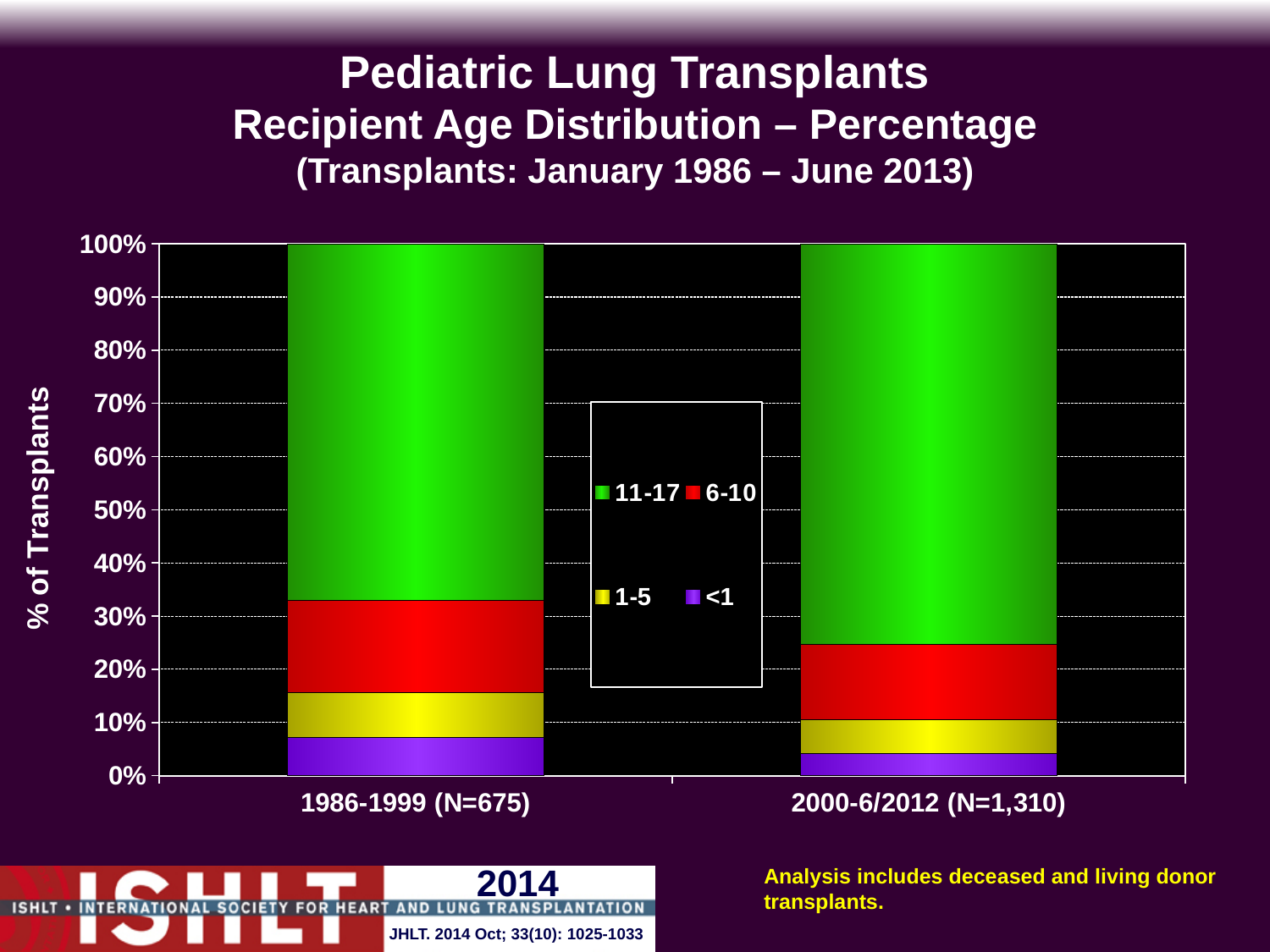
Is the share of 11-17 year old recipients larger in 1986-1999 or in 2000-6/2012? 2000-6/2012 Which age group makes up the largest share of transplants in the 1986-1999 (N=675) bar? 11-17 Which age group makes up the smallest share of transplants in the 2000-6/2012 (N=1,310) bar? <1 Is the share of <1 year old recipients larger in 1986-1999 or in 2000-6/2012? 1986-1999 How many time-period categories are shown on the x axis? 2 Is the share of 11-17 year old recipients in 1986-1999 greater or less than 60%? greater How many age-group series does the legend list? 4 What is the total height of each stacked bar on the y axis? 100% What kind of chart is shown on the slide? Stacked bar chart Is the share of <1 year old recipients in 2000-6/2012 greater or less than 10%? less What is the label of the y axis? % of Transplants Which age group makes up the largest share of transplants in the 2000-6/2012 (N=1,310) bar? 11-17